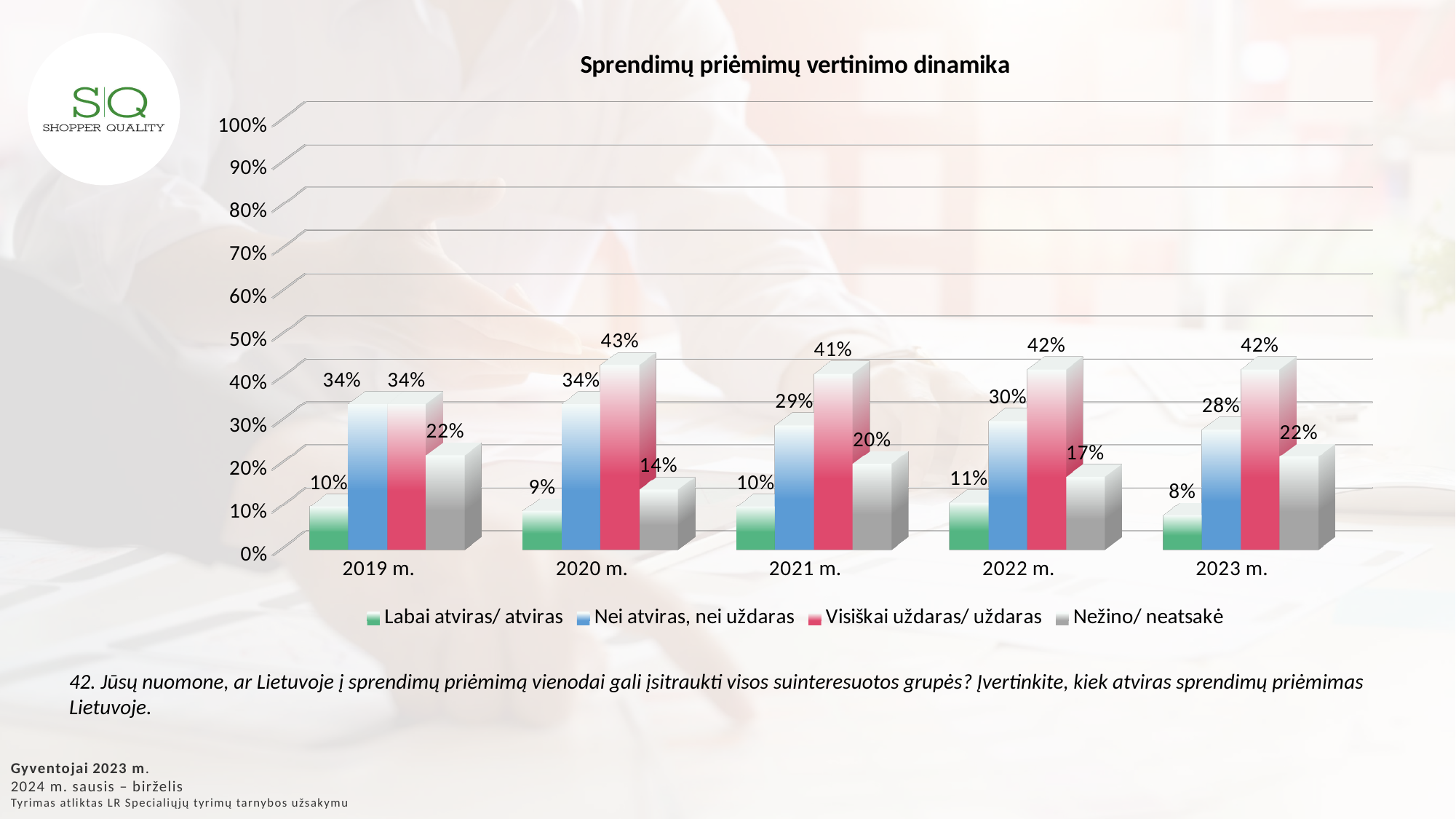
What is the value for "Labai atviras/ atviras" in 2023 m.? 8% What is the value for "Nei atviras, nei uždaras" in 2022 m.? 30% How many series does the legend list? 4 What is the value for "Nežino/ neatsakė" in 2021 m.? 20% In which year is the value for "Labai atviras/ atviras" highest? 2022 m. What is the value for "Visiškai uždaras/ uždaras" in 2020 m.? 43% Which is larger in 2021 m.: "Nei atviras, nei uždaras" or "Visiškai uždaras/ uždaras"? Visiškai uždaras/ uždaras In which year is the value for "Nežino/ neatsakė" lowest? 2020 m. What is the difference between the "Visiškai uždaras/ uždaras" value in 2020 m. and in 2019 m.? 9% What kind of chart is shown on the slide? Bar chart How many years are shown on the x axis? 5 What is the title of the chart? Sprendimų priėmimų vertinimo dinamika